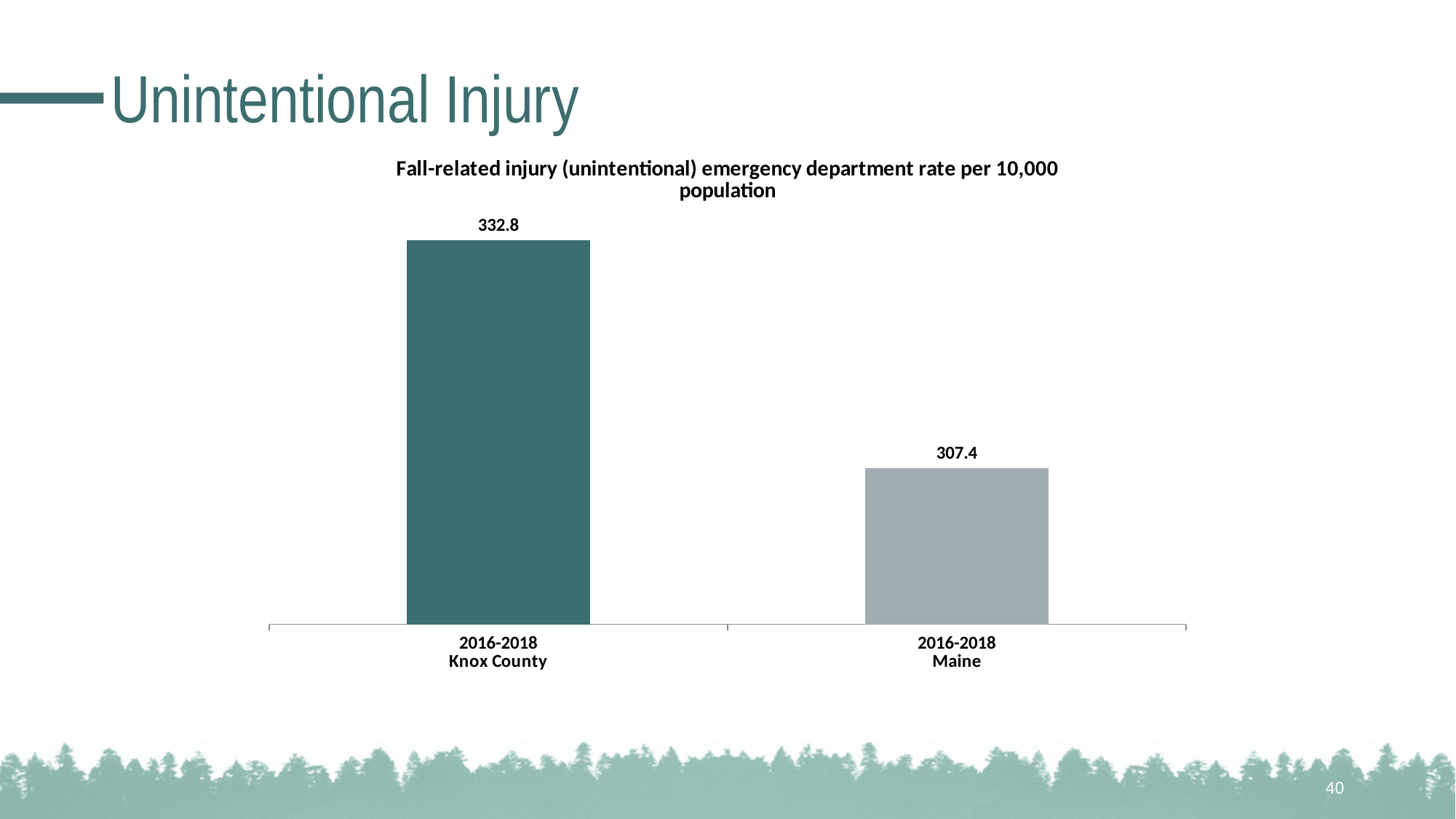
What is the fall-related injury emergency department rate per 10,000 population for Knox County (2016-2018)? 332.8 What type of chart is shown on the slide? bar chart Which category has the lowest fall-related injury emergency department rate? Maine Which category has the higher fall-related injury emergency department rate, Knox County or Maine? Knox County What is the fall-related injury emergency department rate per 10,000 population for Maine (2016-2018)? 307.4 What is the title of the chart? Fall-related injury (unintentional) emergency department rate per 10,000 population How many bars are shown in the chart? 2 What time period do both bars in the chart cover? 2016-2018 What is the difference between the Knox County rate and the Maine rate? 25.4 Is the rate for Maine larger or smaller than the rate for Knox County? smaller